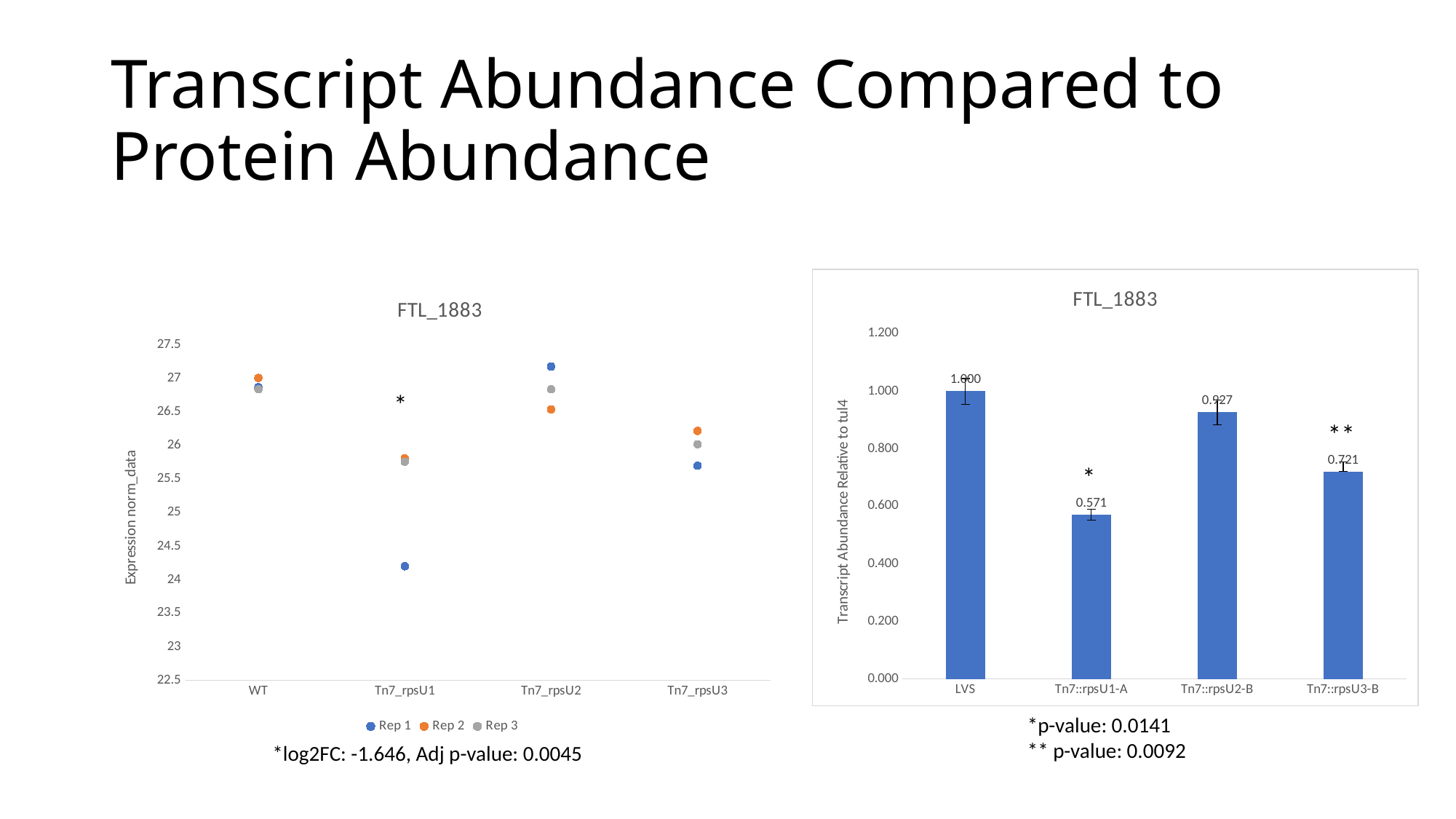
What kind of chart is the chart on the right side of the slide? Bar chart On the left-hand chart, is the Rep 1 value for Tn7_rpsU1 greater or less than 24.5? less On the right-hand bar chart, what is the value for Tn7::rpsU2-B? 0.927 On the right-hand bar chart, which category has the lowest value? Tn7::rpsU1-A What is the y-axis label of the right-hand bar chart? Transcript Abundance Relative to tul4 On the right-hand bar chart, what is the value for Tn7::rpsU1-A? 0.571 On the right-hand bar chart, what is the difference between the values for LVS and Tn7::rpsU1-A? 0.429 On the right-hand bar chart, what is the value for Tn7::rpsU3-B? 0.721 On the right-hand bar chart, which category has the highest value? LVS How many series does the legend of the left-hand chart list? 3 How many categories are shown on the right-hand bar chart? 4 On the right-hand bar chart, which is larger: the value for Tn7::rpsU2-B or Tn7::rpsU3-B? Tn7::rpsU2-B